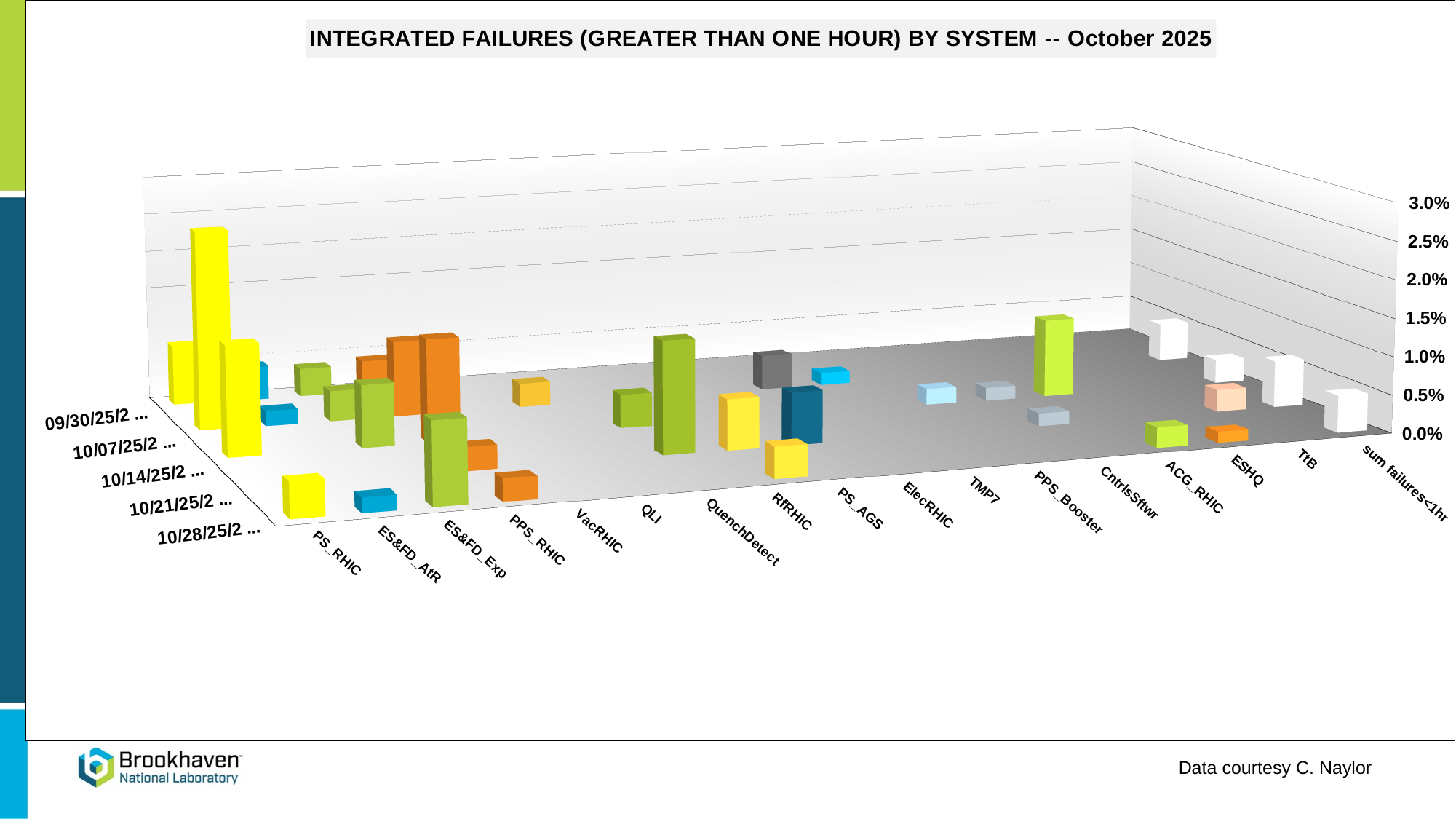
Is the tallest bar for QLI greater or less than 2.0%? less Which system has the tallest bar in the chart? PS_RHIC How many systems are listed along the horizontal axis of the chart? 17 What is the title of the chart? INTEGRATED FAILURES (GREATER THAN ONE HOUR) BY SYSTEM -- October 2025 What kind of chart is shown on the slide? bar chart Is the tallest bar for PS_RHIC greater or less than 2.0%? greater Which system is listed first on the horizontal axis? PS_RHIC What is the highest value labelled on the vertical axis? 3.0% Which date group is listed first on the depth axis? 09/30/25/2 ... Which category is listed last on the horizontal axis? sum failures<1hr How many weekly date groups are shown along the depth axis of the chart? 5